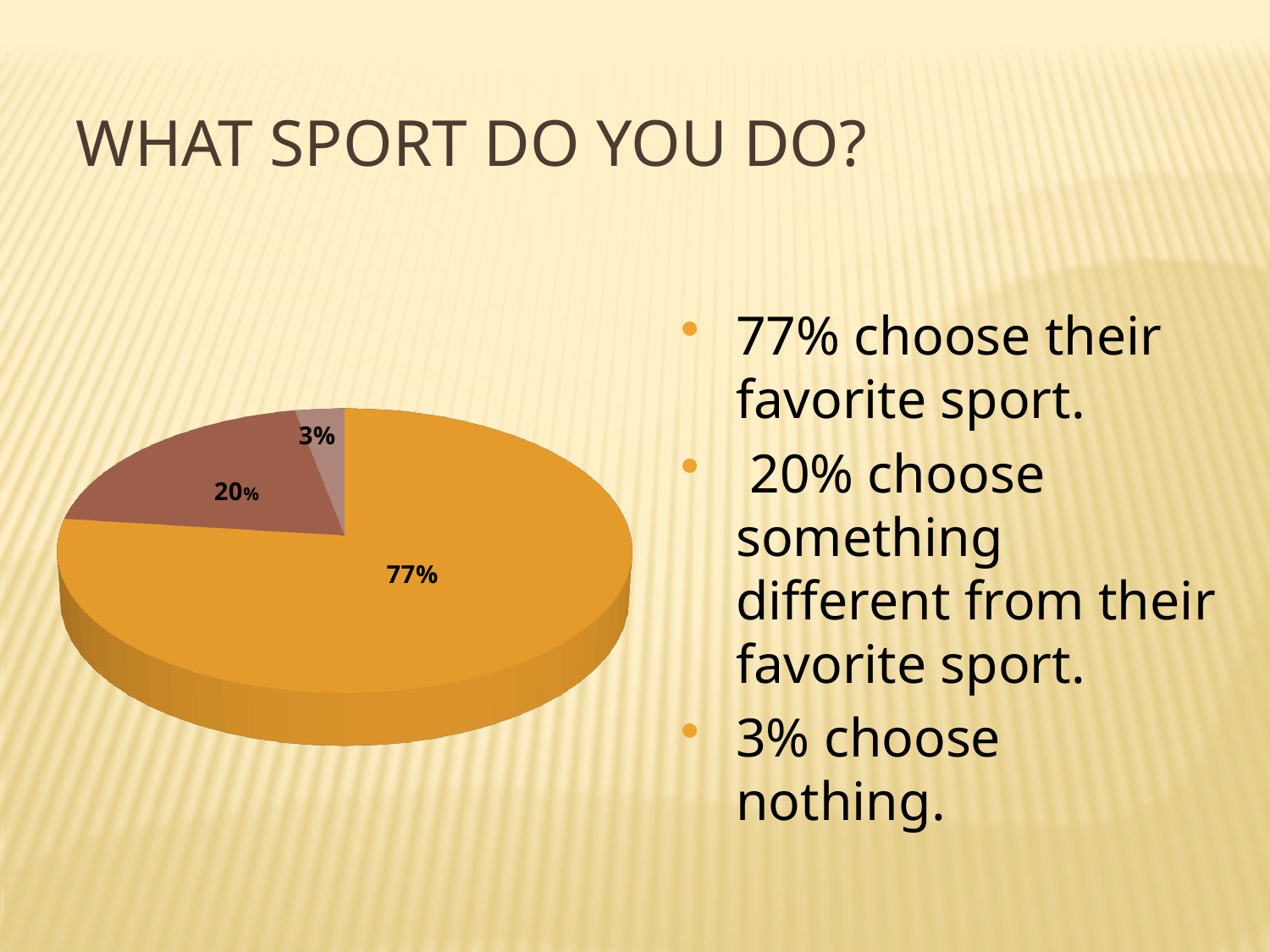
Which is larger: the slice for choosing something different from their favorite sport or the slice for choosing nothing? something different from their favorite sport According to the slide, what share of the pie corresponds to people who choose their favorite sport? 77% What is the difference between the 77% slice and the 20% slice? 57% Is the largest slice of the pie chart greater or less than 50%? greater What is the largest slice of the pie chart? 77% What kind of chart is shown on the slide? pie chart What is the difference between the largest and the smallest slice of the pie chart? 74% What is the smallest slice of the pie chart? 3% How many slices does the pie chart have? 3 According to the slide, what share of the pie corresponds to people who choose something different from their favorite sport? 20% What colour is the largest slice of the pie chart? orange According to the slide, what share of the pie corresponds to people who choose nothing? 3%